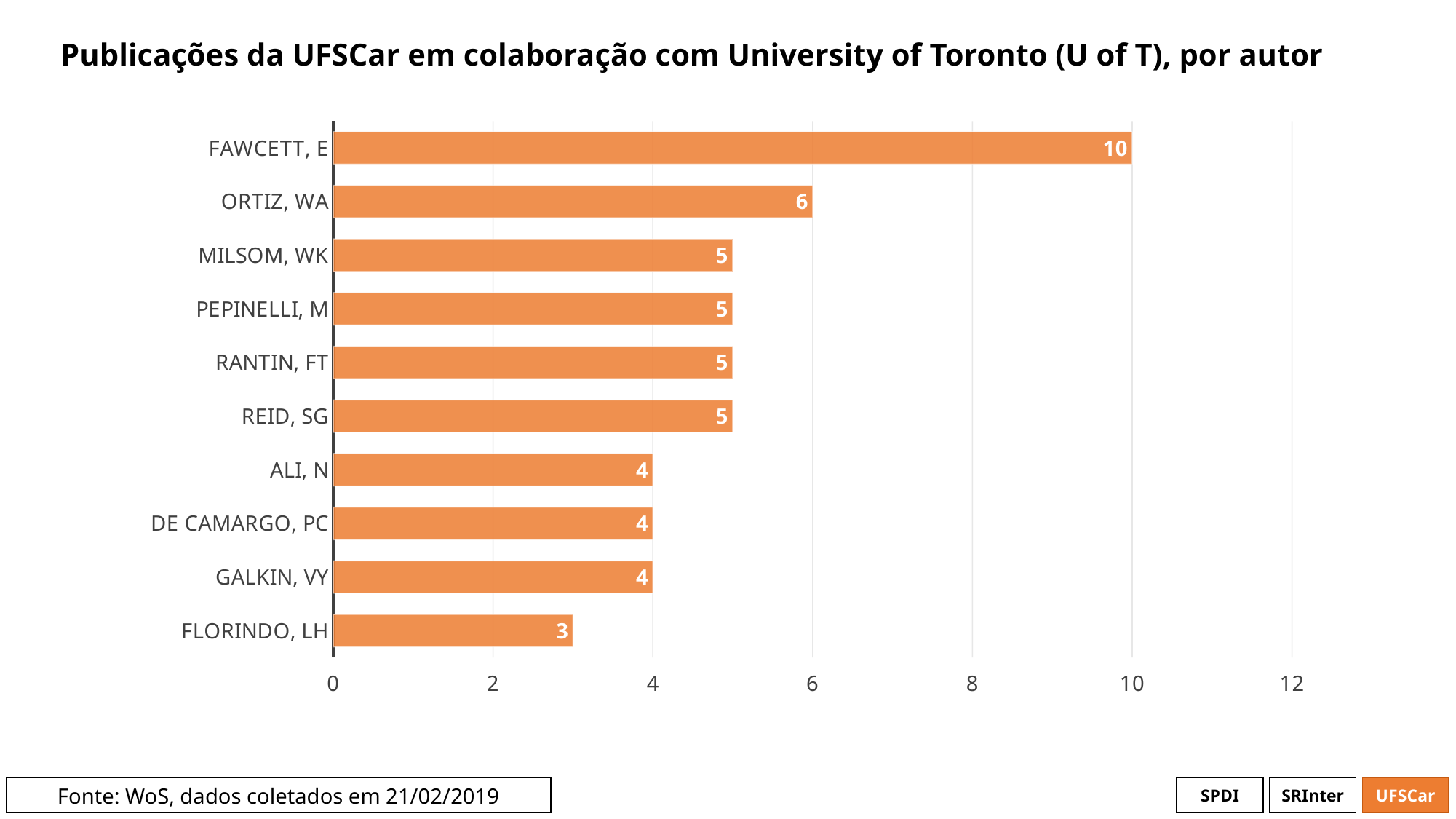
Which is larger, the value for MILSOM, WK or the value for ALI, N? MILSOM, WK What is the value for FLORINDO, LH? 3 How many publications does FAWCETT, E have? 10 What kind of chart is shown on the slide? bar chart Which author has the lowest number of publications? FLORINDO, LH Is the value for FAWCETT, E greater or less than 8? greater What is the value for DE CAMARGO, PC? 4 What is the value for ORTIZ, WA? 6 What is the title of the chart? Publicações da UFSCar em colaboração com University of Toronto (U of T), por autor How many authors are shown in the chart? 10 What is the difference between the values for FAWCETT, E and ORTIZ, WA? 4 Which author has the highest number of publications? FAWCETT, E